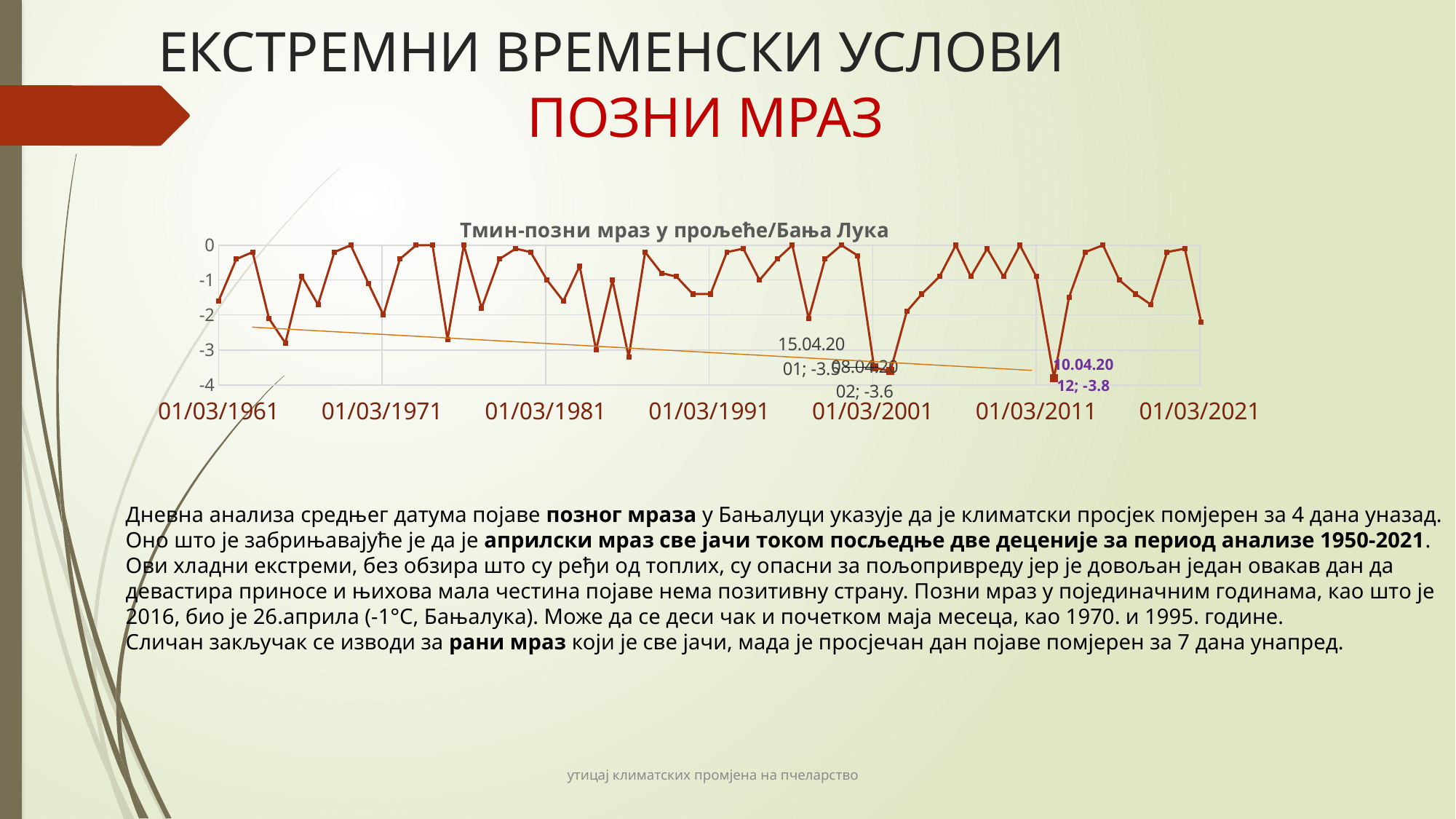
What is the lowest value shown on the vertical axis of the chart? -4 What value is labelled for the point dated 10.04.2012? -3.8 What kind of chart is shown on the slide? line chart What value is labelled for the point dated 15.04.2001? -3.5 How many date labels are shown along the horizontal axis of the chart? 7 Is the value of the first plotted point (at 01/03/1961) greater or less than -1? less Which labelled value is lower, the one for 08.04.2002 or the one for 10.04.2012? 10.04.2012 Does the orange trend line rise or fall from left to right across the chart? fall What value is labelled for the point dated 08.04.2002? -3.6 What is the title of the chart? Тмин-позни мраз у прољеће/Бања Лука Which of the labelled points has the lowest value: 15.04.2001, 08.04.2002 or 10.04.2012? 10.04.2012